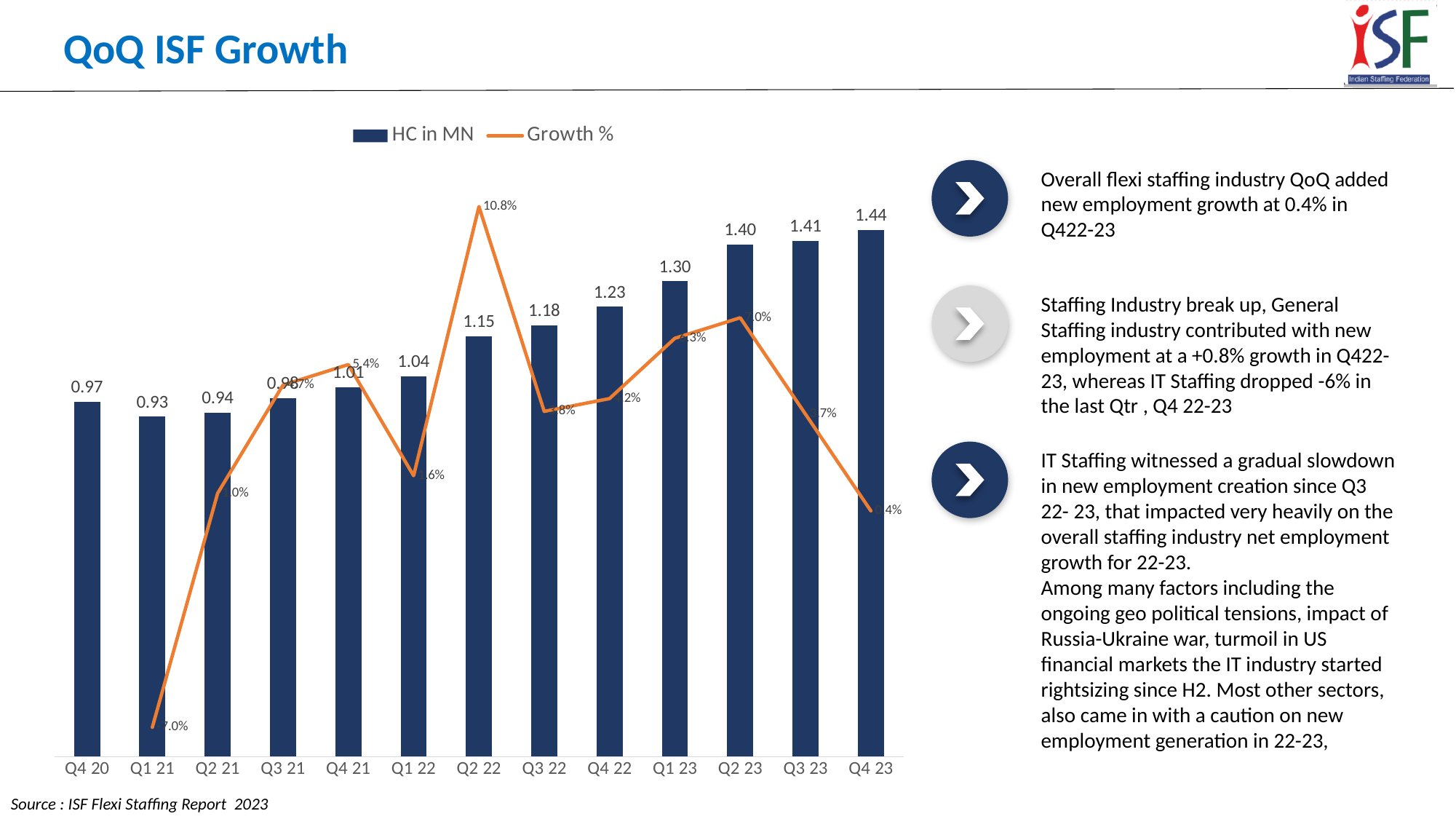
What is the Growth % value for Q2 22? 10.8% Which quarter has the highest HC in MN? Q4 23 What is the HC in MN value for Q4 23? 1.44 How many quarters are shown on the x axis? 13 What is the difference in HC in MN between Q4 23 and Q4 20? 0.47 How many series does the legend list? 2 What is the Growth % value for Q4 21? 5.4% Does the HC in MN series generally rise or fall from Q1 21 to Q4 23? rise Which has a higher HC in MN, Q2 22 or Q4 22? Q4 22 In which quarter does the Growth % line reach its peak? Q2 22 What is the HC in MN value for Q1 22? 1.04 Which quarter has the lowest HC in MN? Q1 21